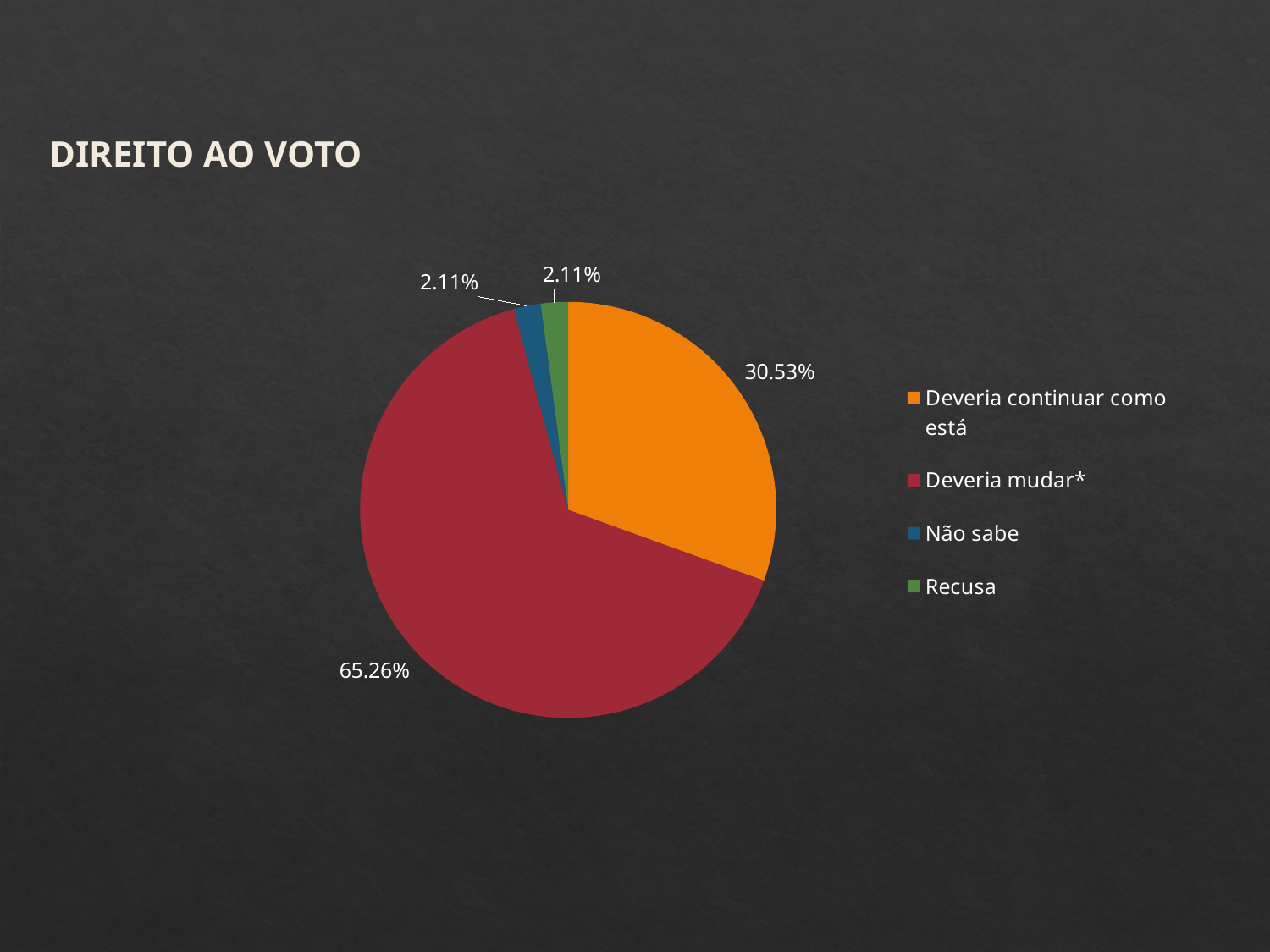
How many categories does the legend list? 4 What share of the pie does "Recusa" represent? 2.11% What is the title of the slide? DIREITO AO VOTO What colour is the slice for "Não sabe"? blue Which is larger, the share for "Deveria continuar como está" or the share for "Recusa"? Deveria continuar como está What is the difference between the shares of "Deveria mudar*" and "Deveria continuar como está"? 34.73% What type of chart is shown on the slide? pie chart What share of the pie does "Deveria mudar*" represent? 65.26% What share of the pie does "Não sabe" represent? 2.11% Which category has the largest slice of the pie? Deveria mudar* Is the share for "Deveria mudar*" greater or less than 50%? greater